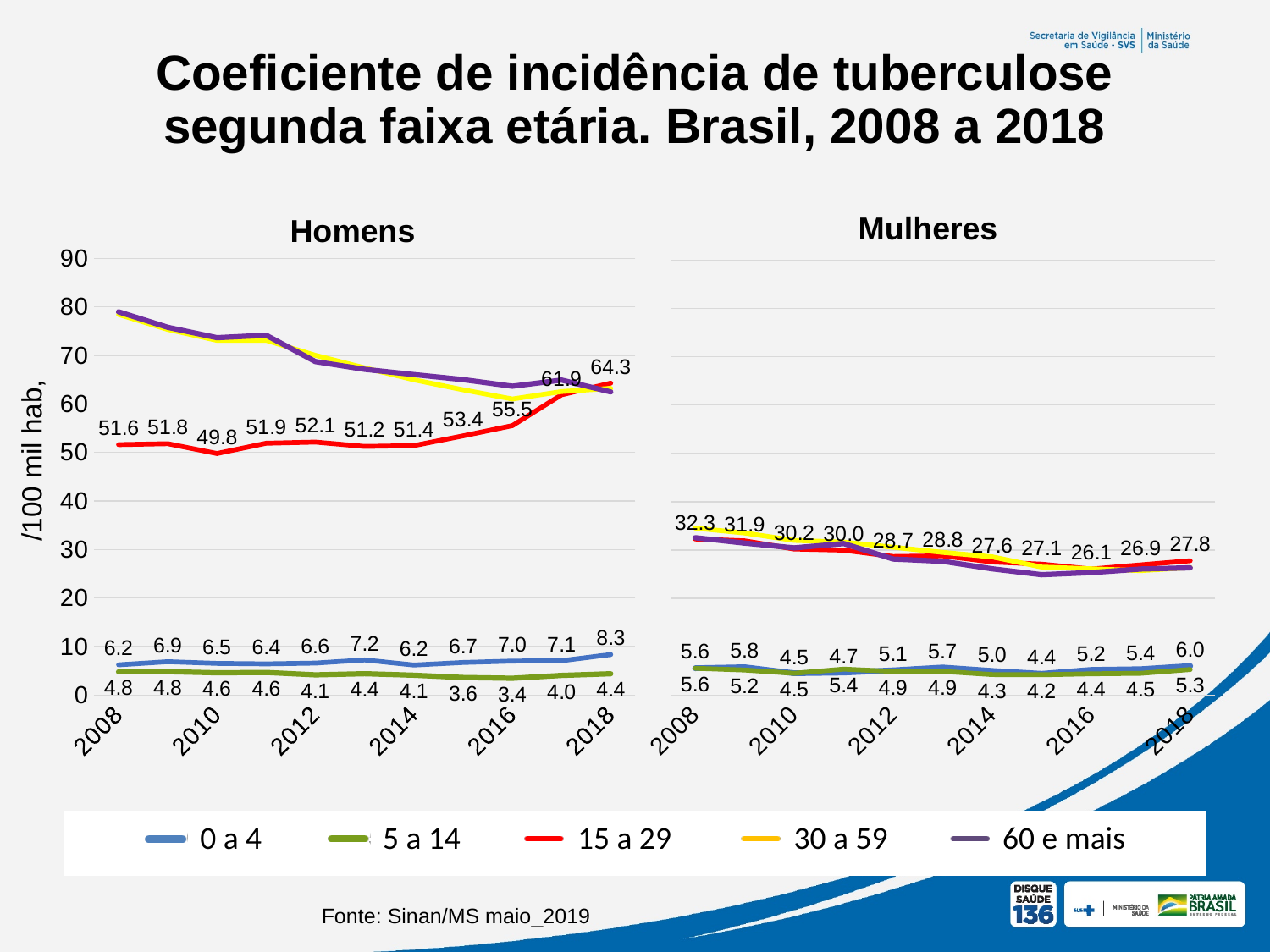
In the Mulheres chart, which is larger in 2018: the 0 a 4 value or the 5 a 14 value? 0 a 4 In the Homens chart, is the value for the 60 e mais series in 2008 greater or less than 70? greater In the Homens chart, in which year is the 15 a 29 series at its lowest? 2010 How many series does the legend list? 5 In the Homens chart, what is the difference between the 15 a 29 values in 2018 and 2008? 12.7 In the Mulheres chart, what is the value for the 5 a 14 series in 2018? 5.3 In the Mulheres chart, in which year is the 15 a 29 series at its lowest? 2016 In the Homens chart, what is the value for the 15 a 29 series in 2018? 64.3 In the Mulheres chart, what is the value for the 15 a 29 series in 2008? 32.3 In the Homens chart, in which year is the 0 a 4 series at its highest? 2018 What kind of chart is used for the Homens and Mulheres panels? line chart In the Homens chart, what is the value for the 0 a 4 series in 2008? 6.2